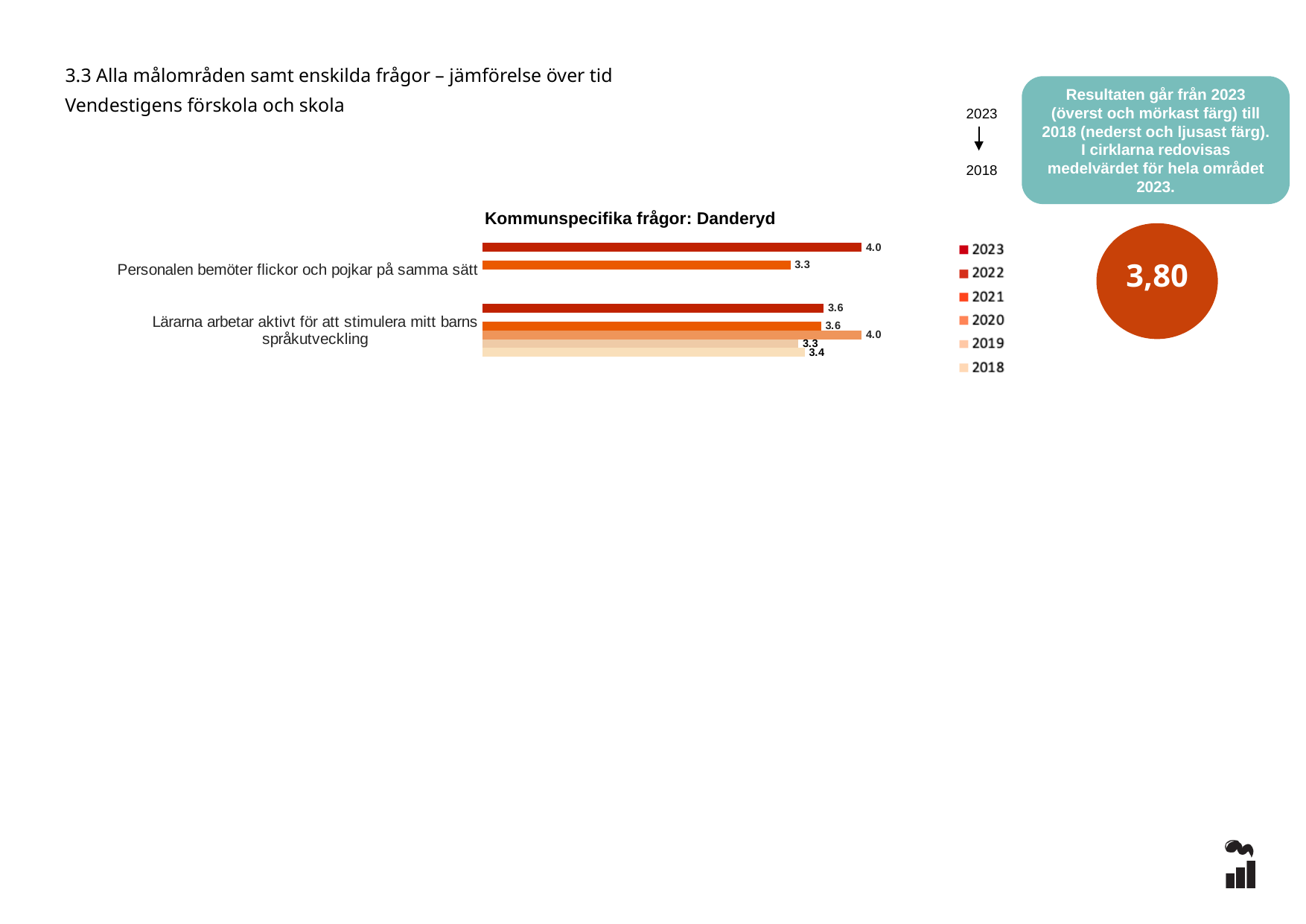
What is the 2023 value for "Lärarna arbetar aktivt för att stimulera mitt barns språkutveckling"? 3.6 How many categories (questions) are shown in the chart? 2 How many series (years) does the legend list? 6 What is the 2021 value for "Lärarna arbetar aktivt för att stimulera mitt barns språkutveckling"? 3.6 What kind of chart is shown on the slide? Bar chart What is the 2023 value for "Personalen bemöter flickor och pojkar på samma sätt"? 4.0 What is the title of the chart? Kommunspecifika frågor: Danderyd Which category has the highest 2023 value? Personalen bemöter flickor och pojkar på samma sätt Which category has the higher 2023 value: "Personalen bemöter flickor och pojkar på samma sätt" or "Lärarna arbetar aktivt för att stimulera mitt barns språkutveckling"? Personalen bemöter flickor och pojkar på samma sätt